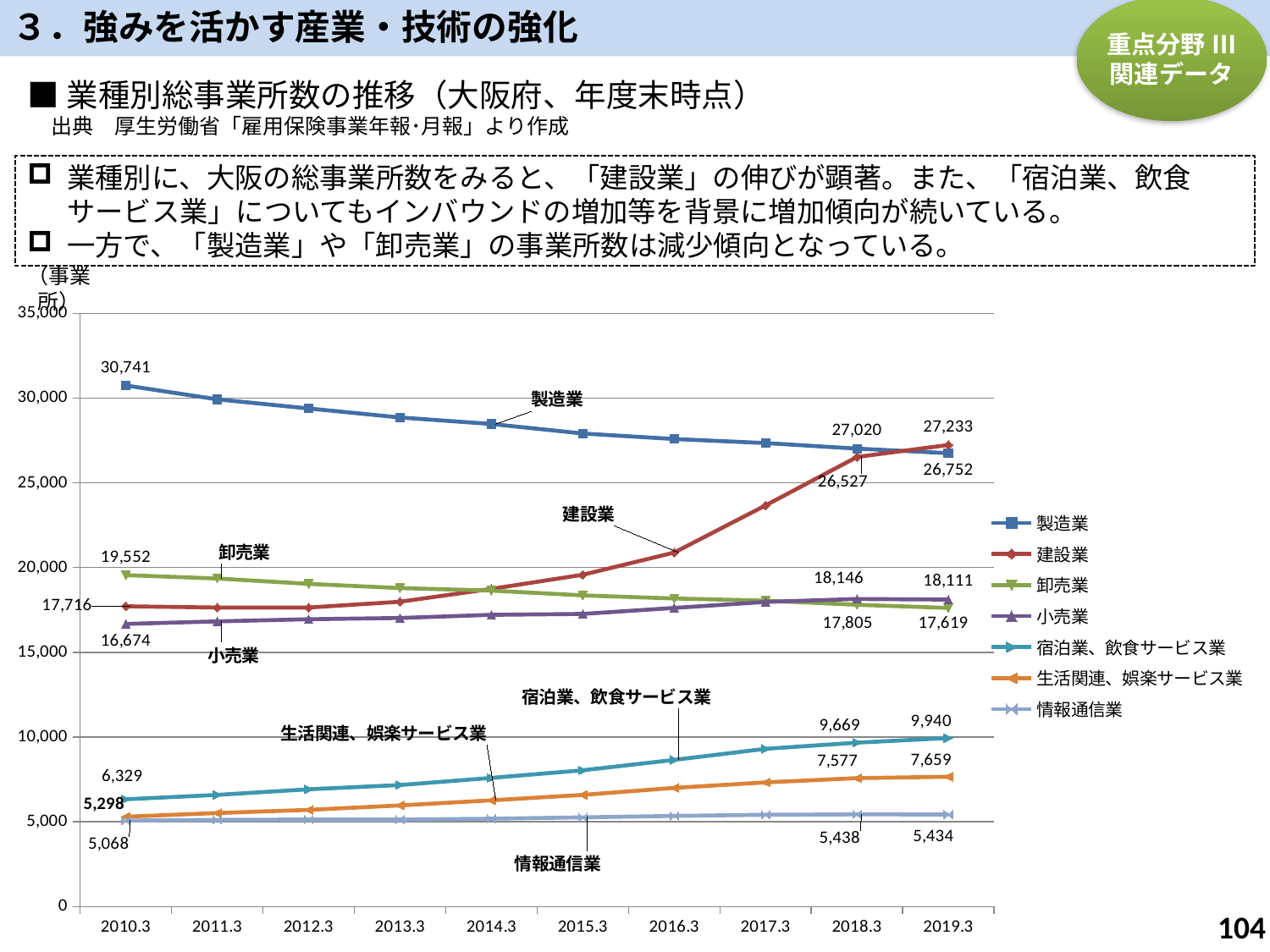
How many time points are shown on the x axis? 10 What is the value for 製造業 at 2010.3? 30,741 Is the value for 建設業 at 2016.3 greater or less than 20,000? greater How many series does the legend list? 7 Does the value for 卸売業 rise or fall from 2010.3 to 2019.3? fall What is the value for 建設業 at 2019.3? 27,233 What kind of chart is shown on the slide? line chart Which series has the highest value at 2010.3? 製造業 What is the value for 宿泊業、飲食サービス業 at 2018.3? 9,669 At 2019.3, which is larger: 建設業 or 製造業? 建設業 Which series has the lowest value at 2019.3? 情報通信業 What is the difference between the 製造業 values at 2010.3 and 2019.3? 3,989